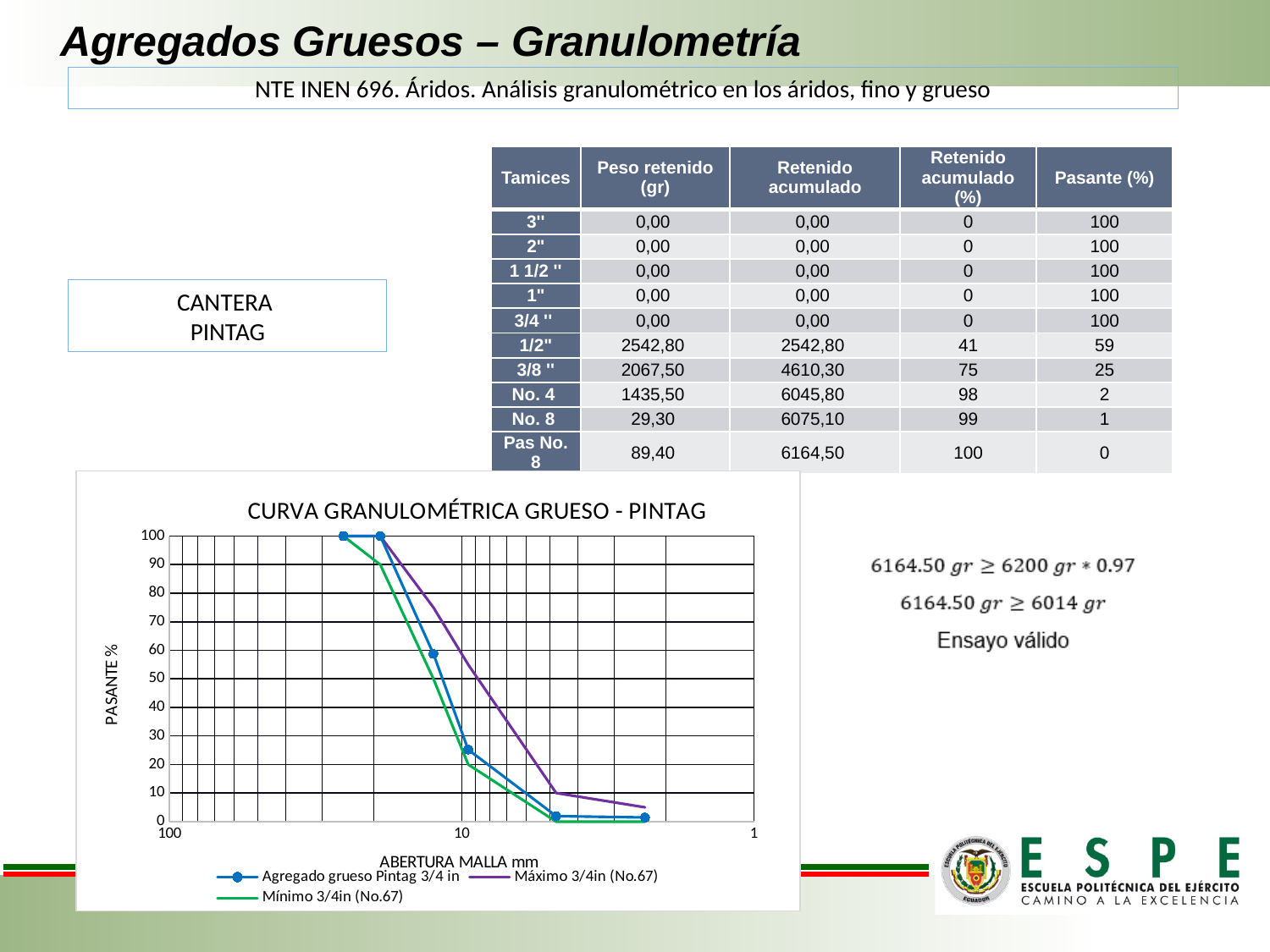
At an abertura of 10 mm, which series is higher: Máximo 3/4in (No.67) or Mínimo 3/4in (No.67)? Máximo 3/4in (No.67) How many marked data points does the Agregado grueso Pintag 3/4 in series have? 6 What is the label of the vertical axis of the chart? PASANTE % Is the value of the Mínimo 3/4in (No.67) series at 10 mm greater or less than 40? less Do the values of the Agregado grueso Pintag 3/4 in series rise or fall moving from left to right along the x axis? fall What kind of chart is shown on the slide? line chart Which series in the chart is drawn in purple? Máximo 3/4in (No.67) What is the title of the chart? CURVA GRANULOMÉTRICA GRUESO - PINTAG Is the lowest value of the Agregado grueso Pintag 3/4 in series greater or less than 10? less Is the value of the Máximo 3/4in (No.67) series at 10 mm greater or less than 20? greater How many series does the legend of the chart list? 3 What is the value of the leftmost point of the Agregado grueso Pintag 3/4 in series? 100